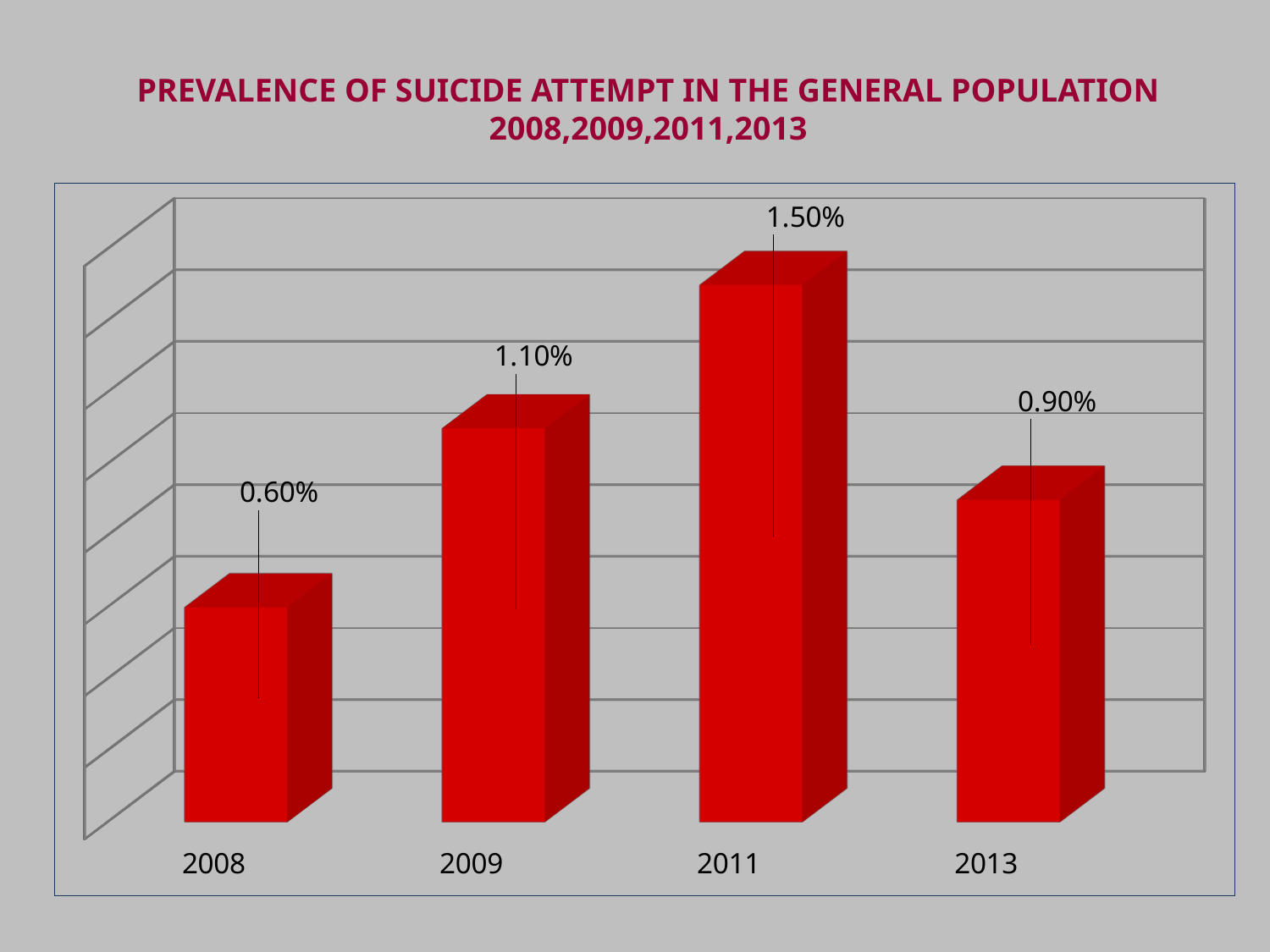
Which year has a higher prevalence, 2009 or 2013? 2009 What is the prevalence of suicide attempt shown for 2011? 1.50% What is the prevalence of suicide attempt shown for 2009? 1.10% What is the difference between the prevalence in 2011 and the prevalence in 2008? 0.90% What is the difference between the prevalence in 2009 and the prevalence in 2013? 0.20% What is the title of the chart on the slide? Prevalence of suicide attempt in the general population 2008,2009,2011,2013 What is the prevalence of suicide attempt shown for 2008? 0.60% What kind of chart is shown on the slide? Bar chart Which year has the lowest prevalence of suicide attempt? 2008 How many years are shown on the chart? 4 Which year has the highest prevalence of suicide attempt? 2011 What is the prevalence of suicide attempt shown for 2013? 0.90%